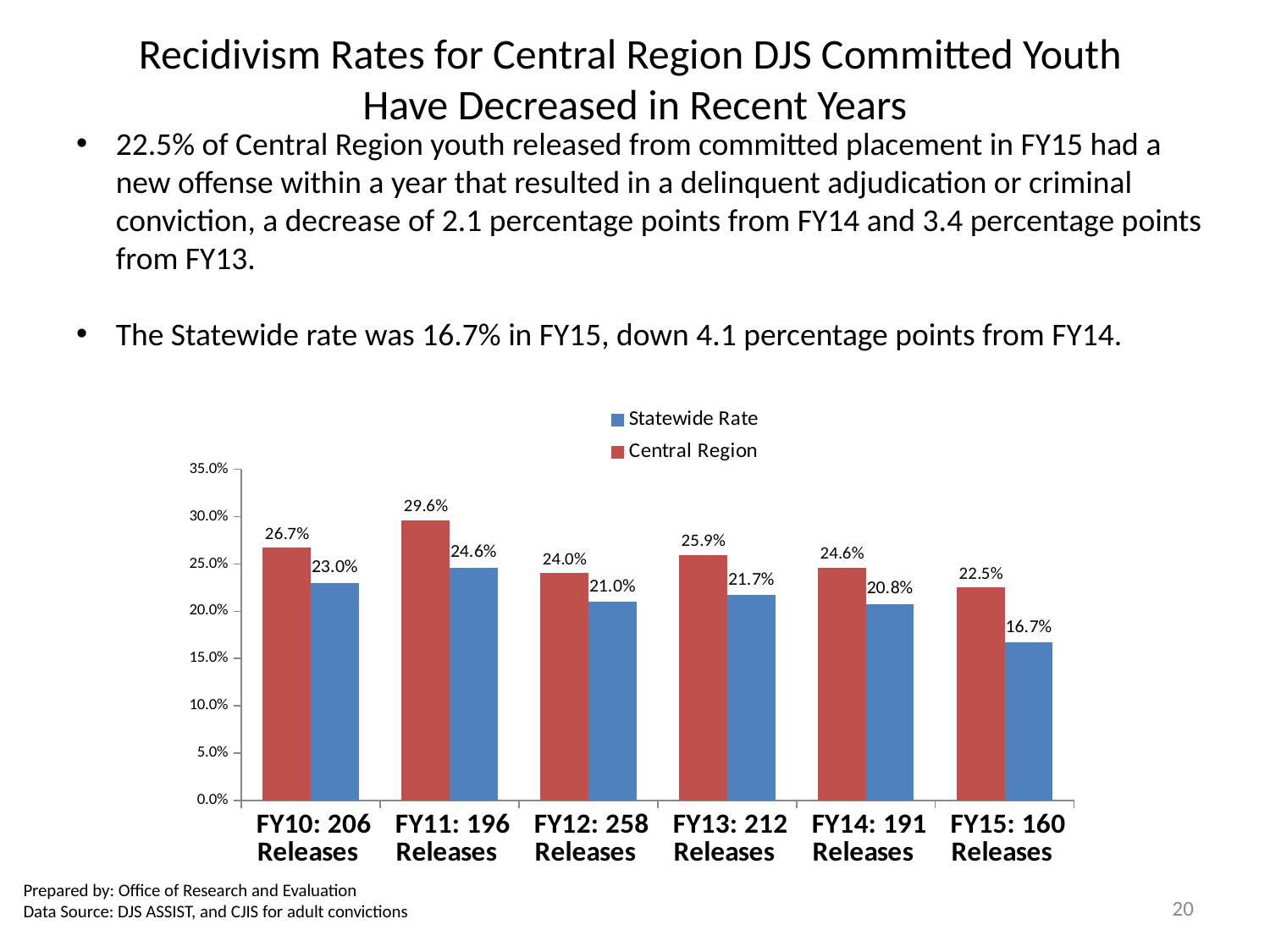
Which is larger for FY13: 212 Releases, the Central Region rate or the Statewide Rate? Central Region Which colour represents the Central Region series in the chart? red Is the Statewide Rate for FY15: 160 Releases greater or less than 20.0%? less How many fiscal year categories are shown on the x axis? 6 How many series does the legend list? 2 What is the difference between the Central Region rate and the Statewide Rate for FY11: 196 Releases? 5.0% Which fiscal year has the highest Central Region rate? FY11: 196 Releases What is the Statewide Rate for FY12: 258 Releases? 21.0% Does the Statewide Rate rise or fall from FY13: 212 Releases to FY15: 160 Releases? fall What kind of chart is shown on the slide? bar chart Which fiscal year has the lowest Statewide Rate? FY15: 160 Releases What is the Central Region recidivism rate for FY15: 160 Releases? 22.5%